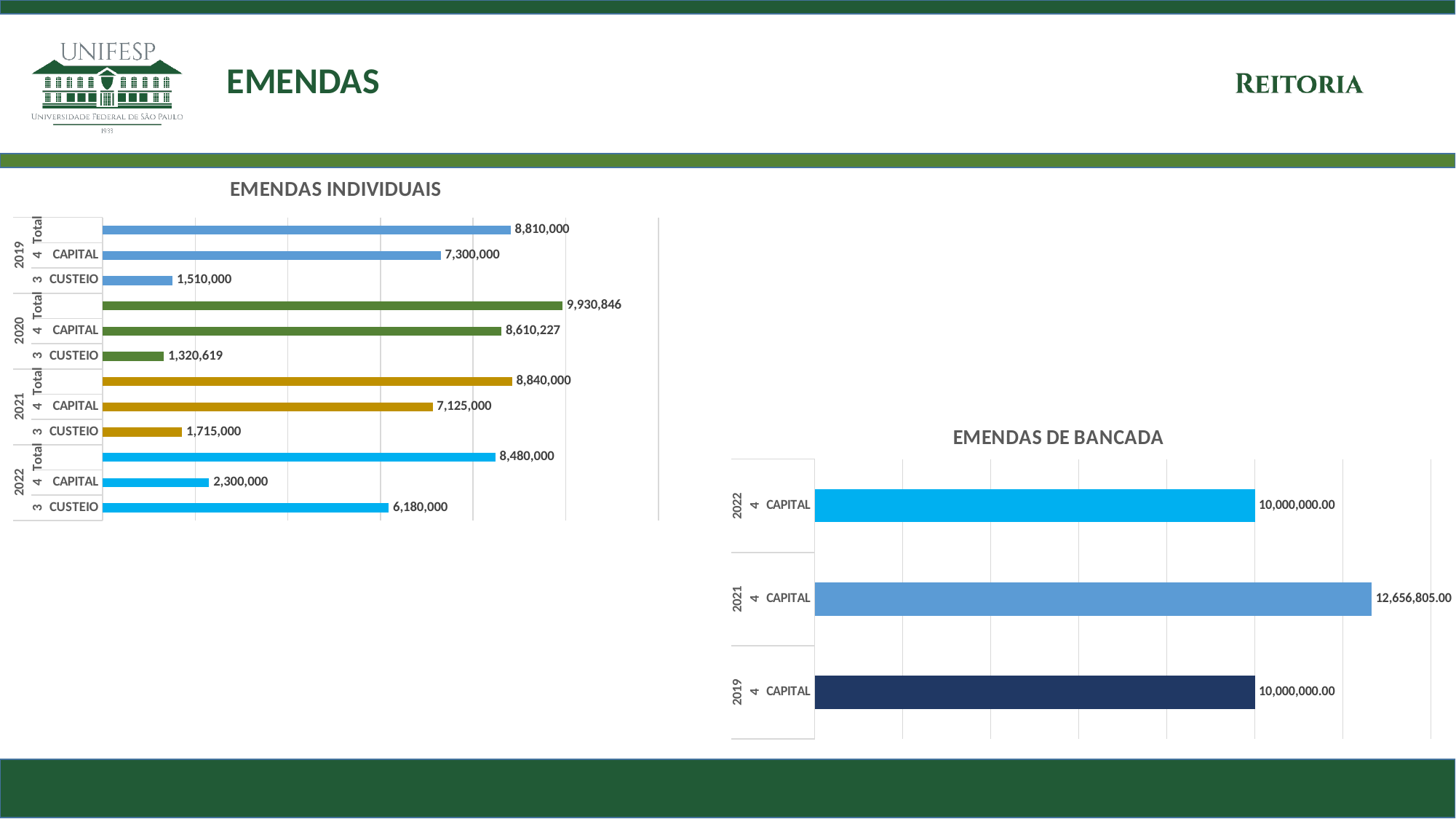
In the EMENDAS INDIVIDUAIS chart, how many bars are plotted? 12 In the EMENDAS INDIVIDUAIS chart, what is the Total for 2020? 9,930,846 In the EMENDAS DE BANCADA chart, what is the value for CAPITAL in 2021? 12,656,805.00 In the EMENDAS INDIVIDUAIS chart, which year has the lowest CUSTEIO value? 2020 In the EMENDAS DE BANCADA chart, what is the difference between the 2021 value and the 2019 value? 2,656,805.00 In the EMENDAS INDIVIDUAIS chart, what is the value for CAPITAL in 2019? 7,300,000 In the EMENDAS INDIVIDUAIS chart, which is larger: CAPITAL in 2021 or CAPITAL in 2019? CAPITAL in 2019 In the EMENDAS INDIVIDUAIS chart, which year has the highest Total? 2020 What kind of chart is the EMENDAS DE BANCADA chart? Bar chart In the EMENDAS INDIVIDUAIS chart, what is the value for CUSTEIO in 2022? 6,180,000 In the EMENDAS DE BANCADA chart, which year has the highest value? 2021 In the EMENDAS INDIVIDUAIS chart, what is the difference between the CAPITAL values for 2020 and 2022? 6,310,227